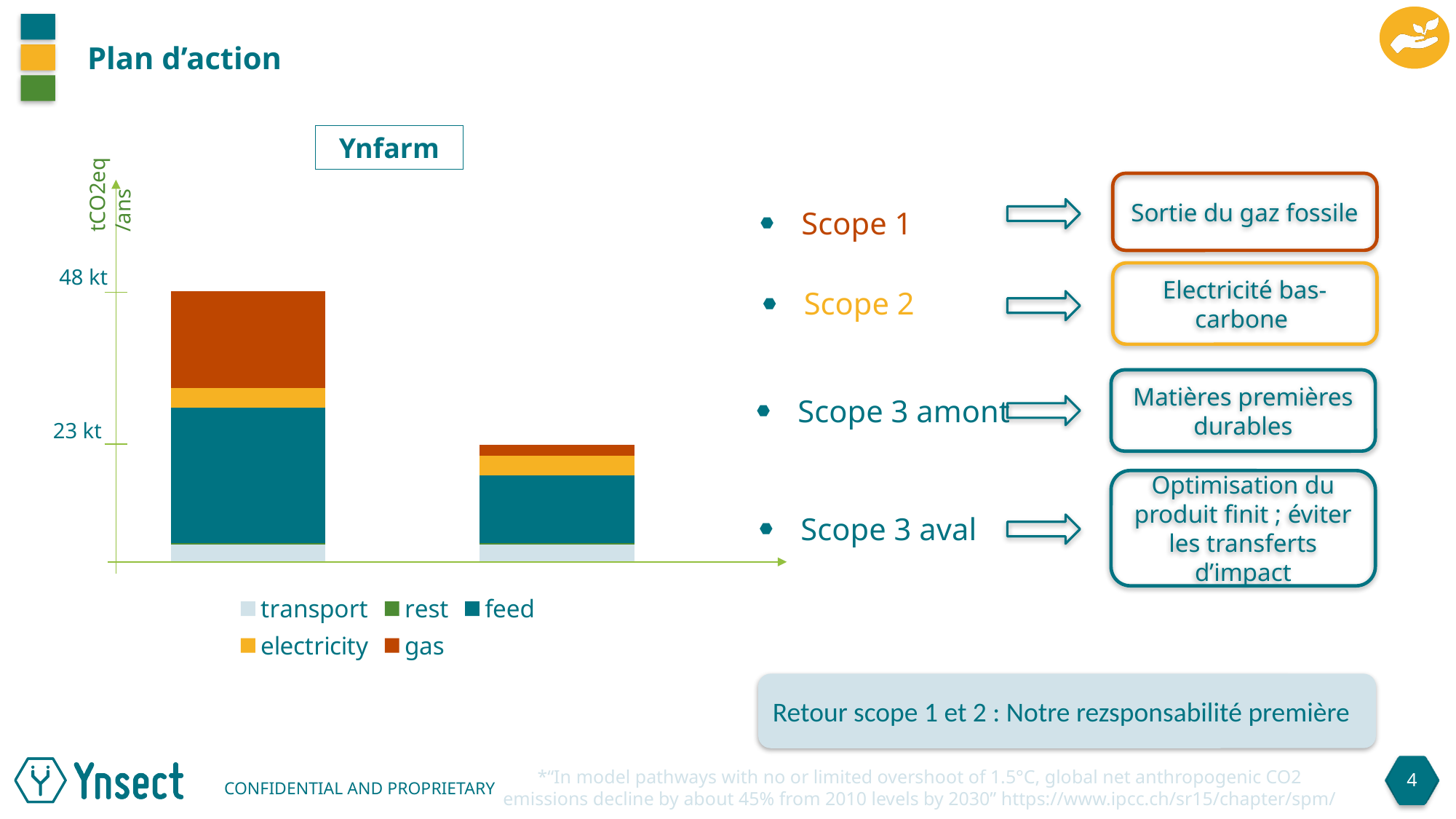
Is the gas segment larger in the left bar or the right bar? the left bar What is the title shown above the chart? Ynfarm What is the label on the y axis of the chart? tCO2eq /ans How many bars are plotted in the chart? 2 Which bar is taller, the left bar or the right bar? the left bar What kind of chart is shown on the slide? bar chart Do the bar totals rise or fall from left to right? fall What is the total value of the left bar, as marked on the y axis? 48 kt Is the total of the left bar greater or less than 23 kt? greater Which series forms the largest segment of the left bar? feed How many series does the chart legend list? 5